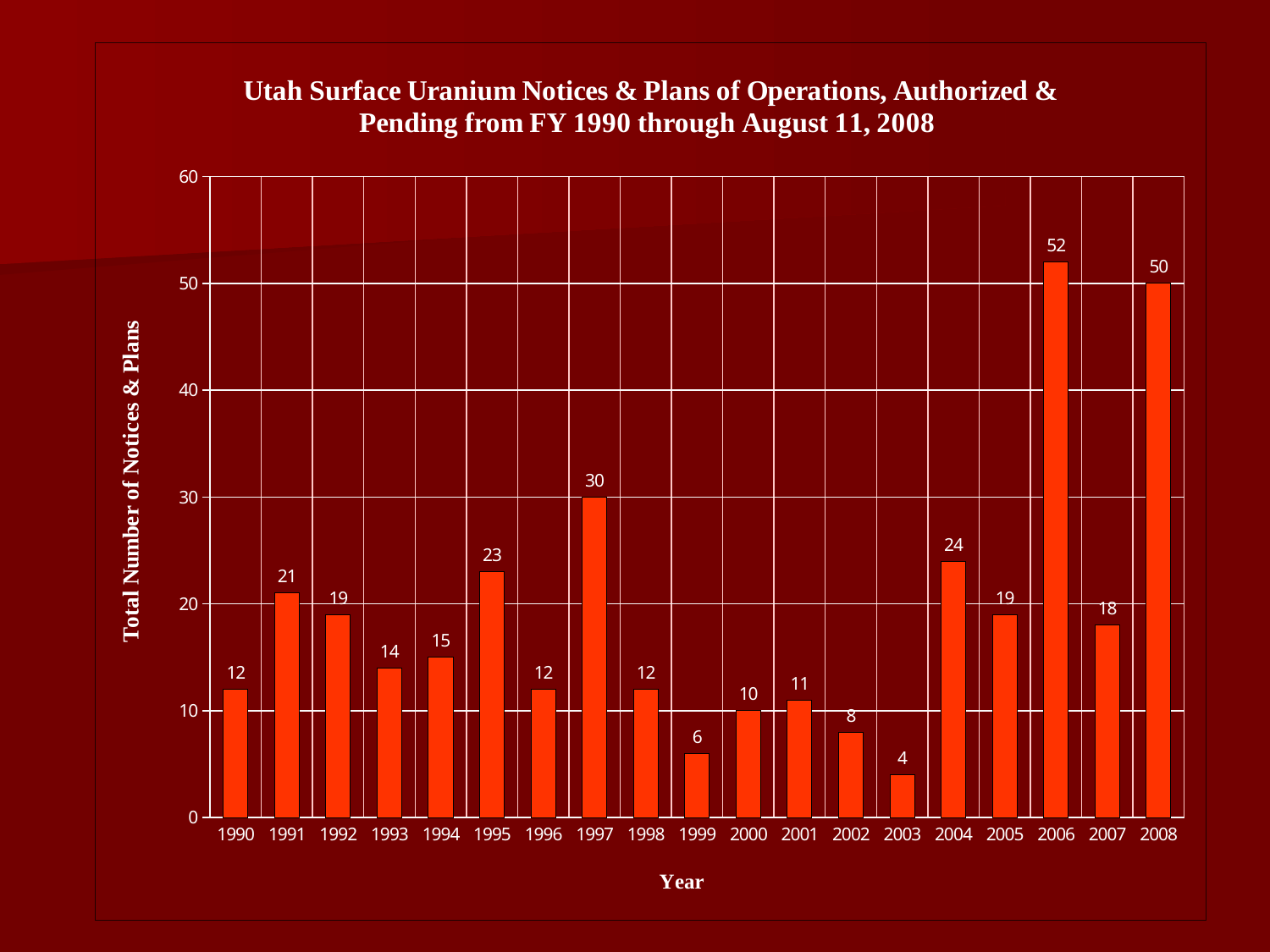
What is the difference between the values for 1997 and 1999? 24 Which year has the lowest total number of notices and plans? 2003 What is the value for 2006? 52 What is the value for 2003? 4 What kind of chart is this? bar chart Which is larger, the value for 1995 or the value for 2004? 2004 What is the label of the y axis? Total Number of Notices & Plans How many years are shown on the x axis? 19 What is the value for 1997? 30 What is the difference between the values for 2006 and 2008? 2 Which year has the highest total number of notices and plans? 2006